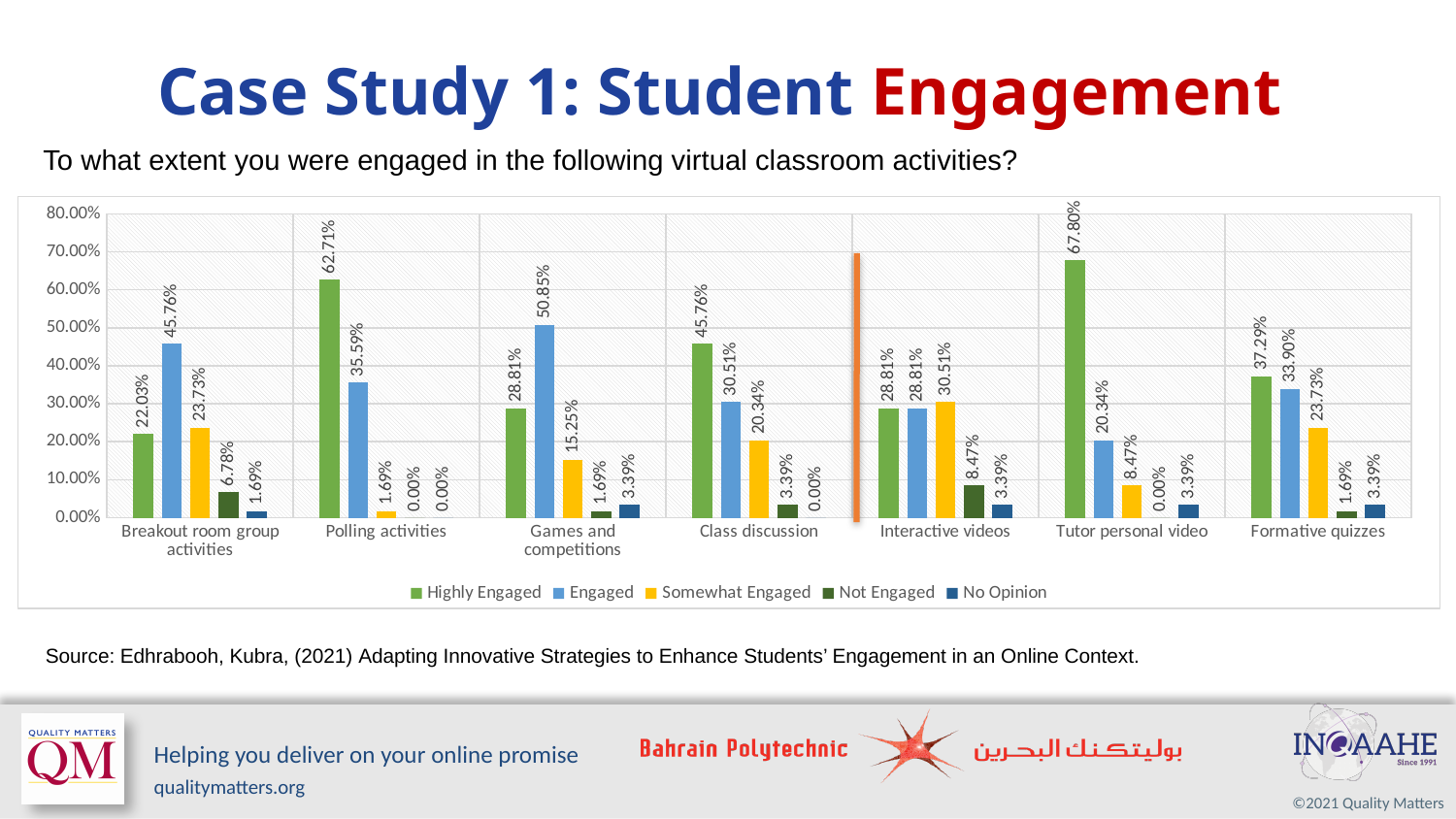
How many virtual classroom activities are shown on the x axis? 7 Which activity has the highest Highly Engaged percentage? Tutor personal video What is the Engaged value for Games and competitions? 50.85% What is the Not Engaged value for Breakout room group activities? 6.78% Which colour represents the Somewhat Engaged series in the legend? Yellow What percentage of students were Highly Engaged in Tutor personal video? 67.80% Which is larger for Class discussion: the Highly Engaged value or the Engaged value? Highly Engaged What is the difference between the Highly Engaged and Engaged values for Polling activities? 27.12% What is the Somewhat Engaged value for Interactive videos? 30.51% What kind of chart is shown on the slide? Bar chart Which activity has the lowest Highly Engaged percentage? Breakout room group activities How many series does the legend list? 5